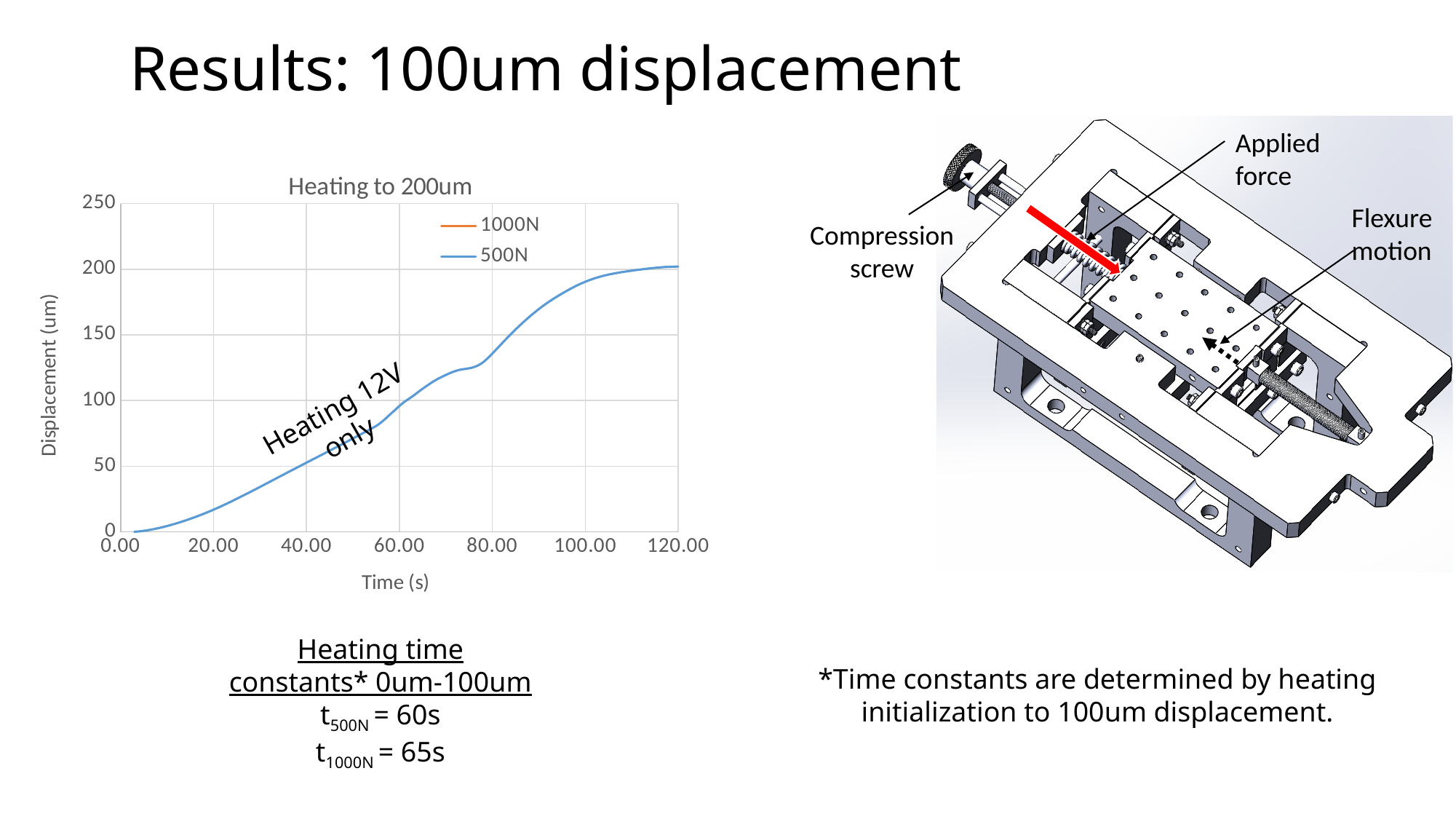
Is the displacement at 120.00 s greater or less than 250 um? less How many series does the chart legend list? 2 Is the displacement at 120.00 s greater or less than 150 um? greater What kind of chart is shown on the slide? line chart Is the displacement at 80.00 s greater or less than 100 um? greater Which is larger, the displacement at 100.00 s or the displacement at 40.00 s? 100.00 s What are the two series named in the chart legend? 1000N and 500N What is the title of the chart? Heating to 200um Does the displacement rise or fall as time increases along the x axis? rise